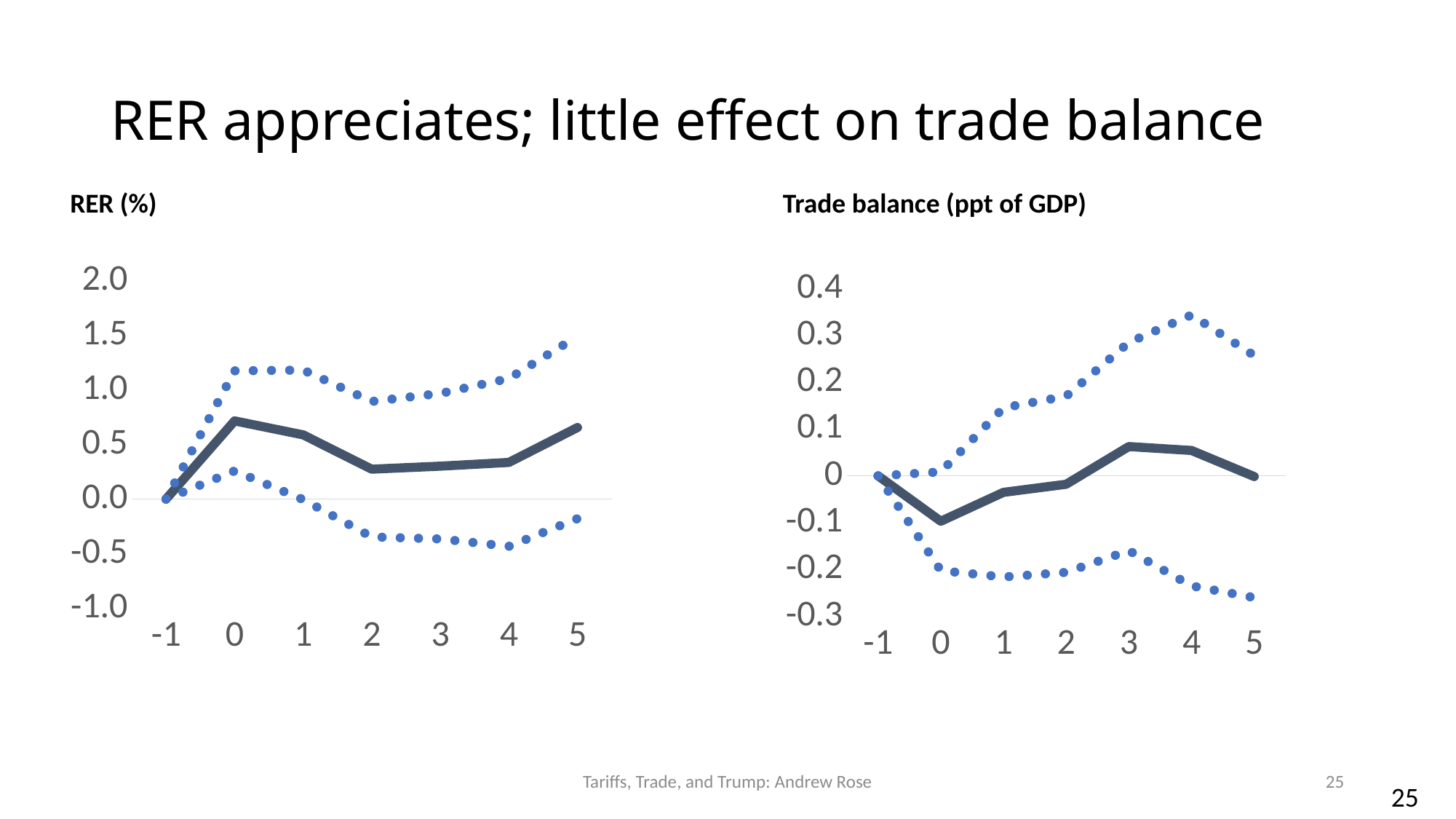
In the 'Trade balance (ppt of GDP)' chart, is the upper dotted line at x = 4 greater or less than 0.3? greater In the 'RER (%)' chart, which is larger for the solid line: the value at x = 0 or the value at x = 2? x = 0 What is the title of the chart on the right of the slide? Trade balance (ppt of GDP) In the 'Trade balance (ppt of GDP)' chart, at which x value is the solid line lowest? 0 In the 'RER (%)' chart, does the solid line rise or fall from x = -1 to x = 0? rise What kind of chart is the 'RER (%)' chart on the left? line chart In the 'RER (%)' chart, how many points are labelled on the x axis? 7 In the 'Trade balance (ppt of GDP)' chart, does the solid line rise or fall from x = -1 to x = 0? fall In the 'RER (%)' chart, is the value of the solid line at x = 2 greater or less than 0.5? less In the 'Trade balance (ppt of GDP)' chart, what is the value of the solid line at x = -1? 0 In the 'RER (%)' chart, what is the value of the solid line at x = -1? 0.0 In the 'RER (%)' chart, is the value of the solid line at x = 0 greater or less than 0.5? greater